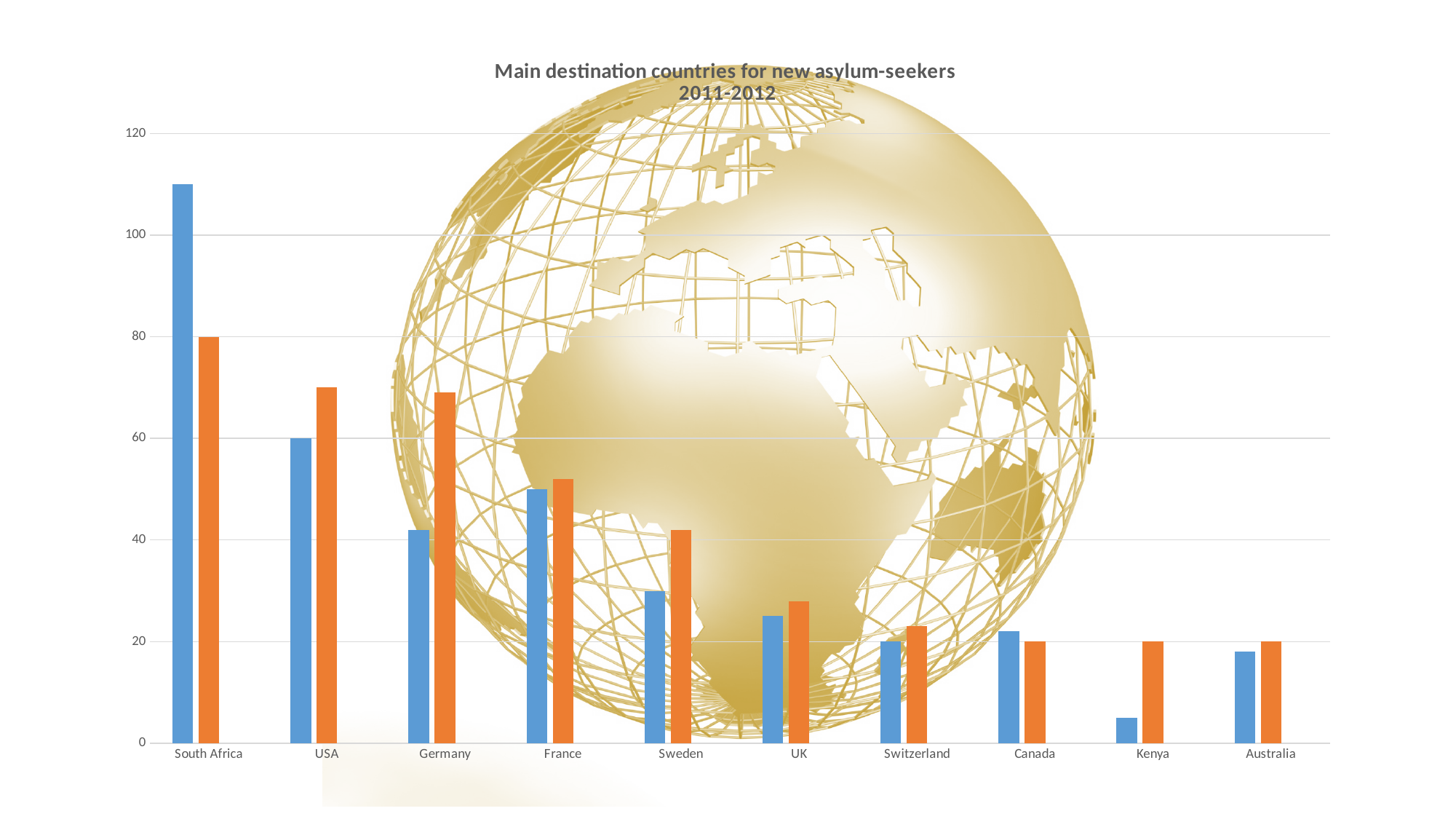
Is the value of the blue bar for South Africa greater or less than 100? greater Is the value of the blue bar for Sweden greater or less than 40? less What kind of chart is shown on the slide? bar chart How many countries are shown on the x axis of the chart? 10 For USA, which bar is larger, the blue bar or the orange bar? orange What is the title of the chart? Main destination countries for new asylum-seekers 2011-2012 Which country has the tallest bar in the chart? South Africa What is the value of the orange bar for South Africa? 80 What is the difference between the orange bar for South Africa and the blue bar for USA? 20 What is the value of the blue bar for USA? 60 Which country has the shortest bar in the chart? Kenya Is the value of the orange bar for Germany greater or less than 60? greater